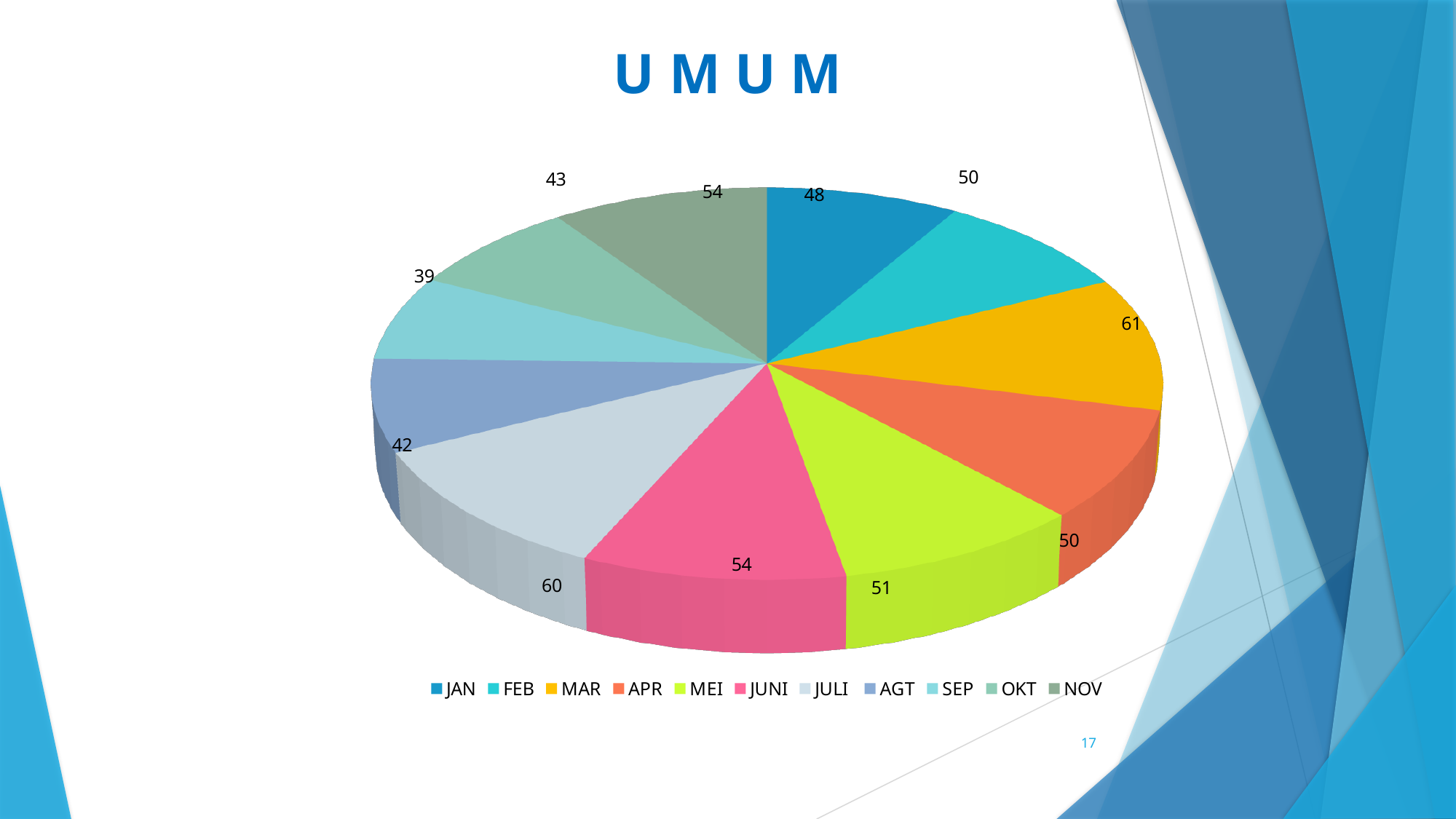
What is the value for JAN? 48 What is the difference between the values for JULI and AGT? 18 How many slices does the pie chart have? 11 What is the value for MAR? 61 What is the title of the chart? UMUM What is the value for JULI? 60 Which is larger, the value for JULI or the value for JUNI? JULI Which month has the smallest slice? SEP What type of chart is shown on the slide? pie chart What is the value for SEP? 39 What is the difference between the values for MAR and SEP? 22 Which month has the largest slice? MAR